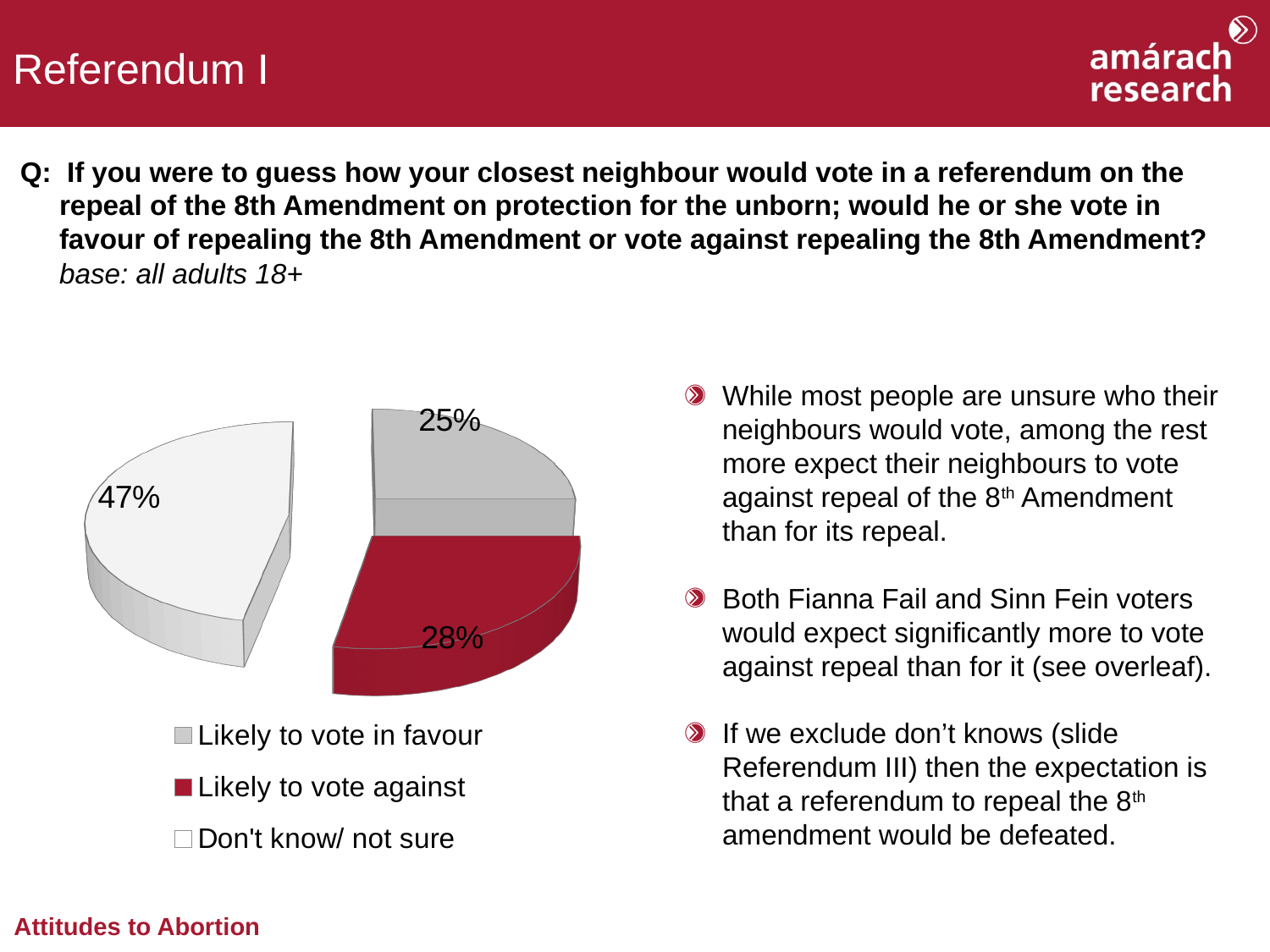
What kind of chart is shown on the slide? pie chart Which is larger: 'Likely to vote against' or 'Likely to vote in favour'? Likely to vote against What percentage of respondents think their neighbour is likely to vote in favour? 25% How many entries does the legend list? 3 What is the difference between the 'Don't know/ not sure' share and the 'Likely to vote against' share? 19% Which category has the largest share of the pie? Don't know/ not sure What colour is the 'Likely to vote against' slice? red Which category has the smallest share of the pie? Likely to vote in favour What percentage of respondents answered 'Don't know/ not sure'? 47% What is the difference between the 'Likely to vote against' and 'Likely to vote in favour' shares? 3% What percentage of respondents think their neighbour is likely to vote against? 28% How many slices does the pie chart have? 3